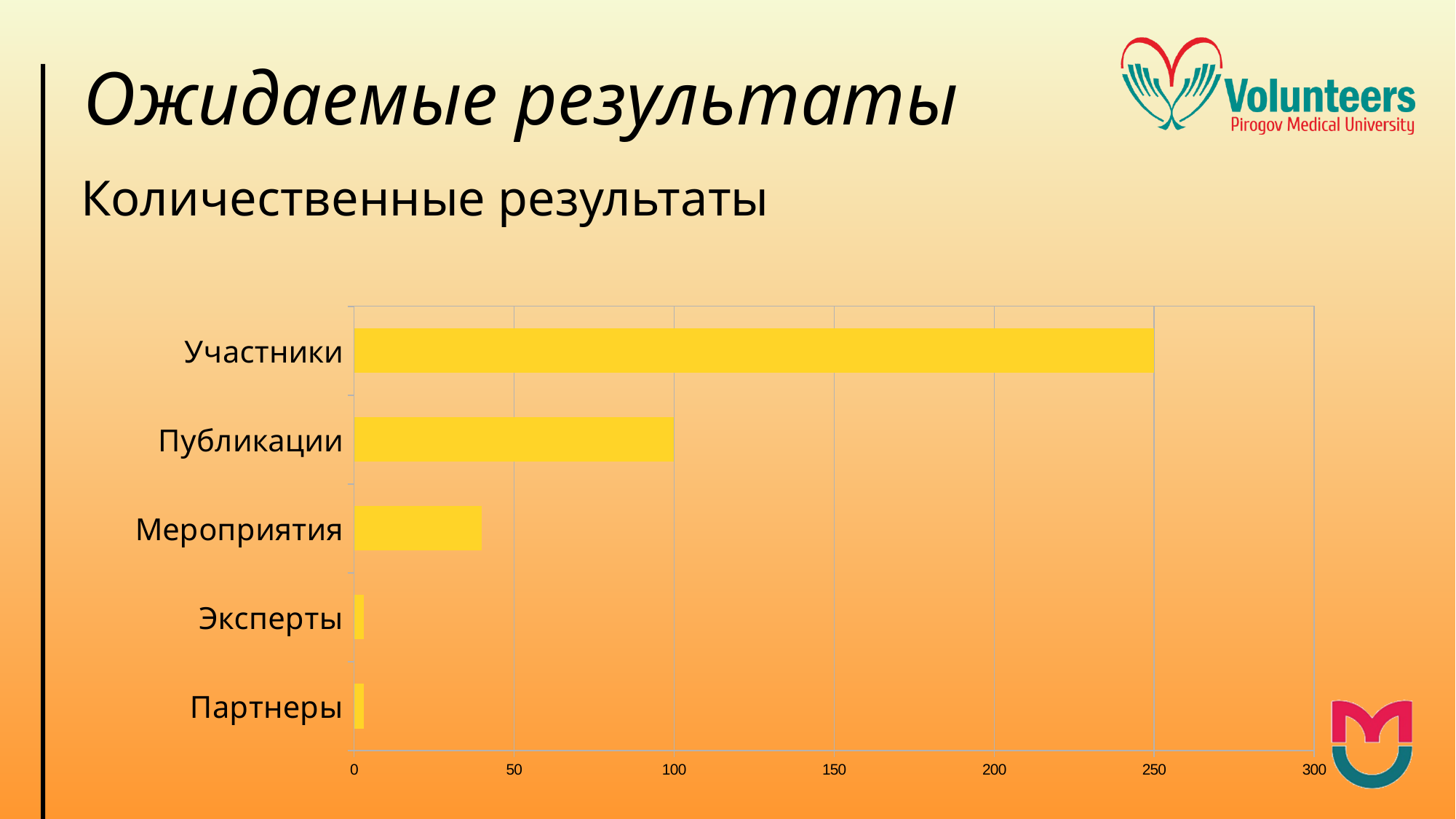
Which category has the highest value in the chart? Участники Is the value for Эксперты greater or less than 50? less What is the difference between the values for Участники and Публикации? 150 Which is larger, the value for Участники or the value for Публикации? Участники What is the value for Участники? 250 What is the highest value shown on the horizontal axis of the chart? 300 How many categories are plotted in the chart? 5 Is the value for Участники greater or less than 200? greater Is the value for Мероприятия greater or less than 50? less Which is larger, the value for Публикации or the value for Мероприятия? Публикации What kind of chart is shown on the slide? bar chart What is the value for Публикации? 100